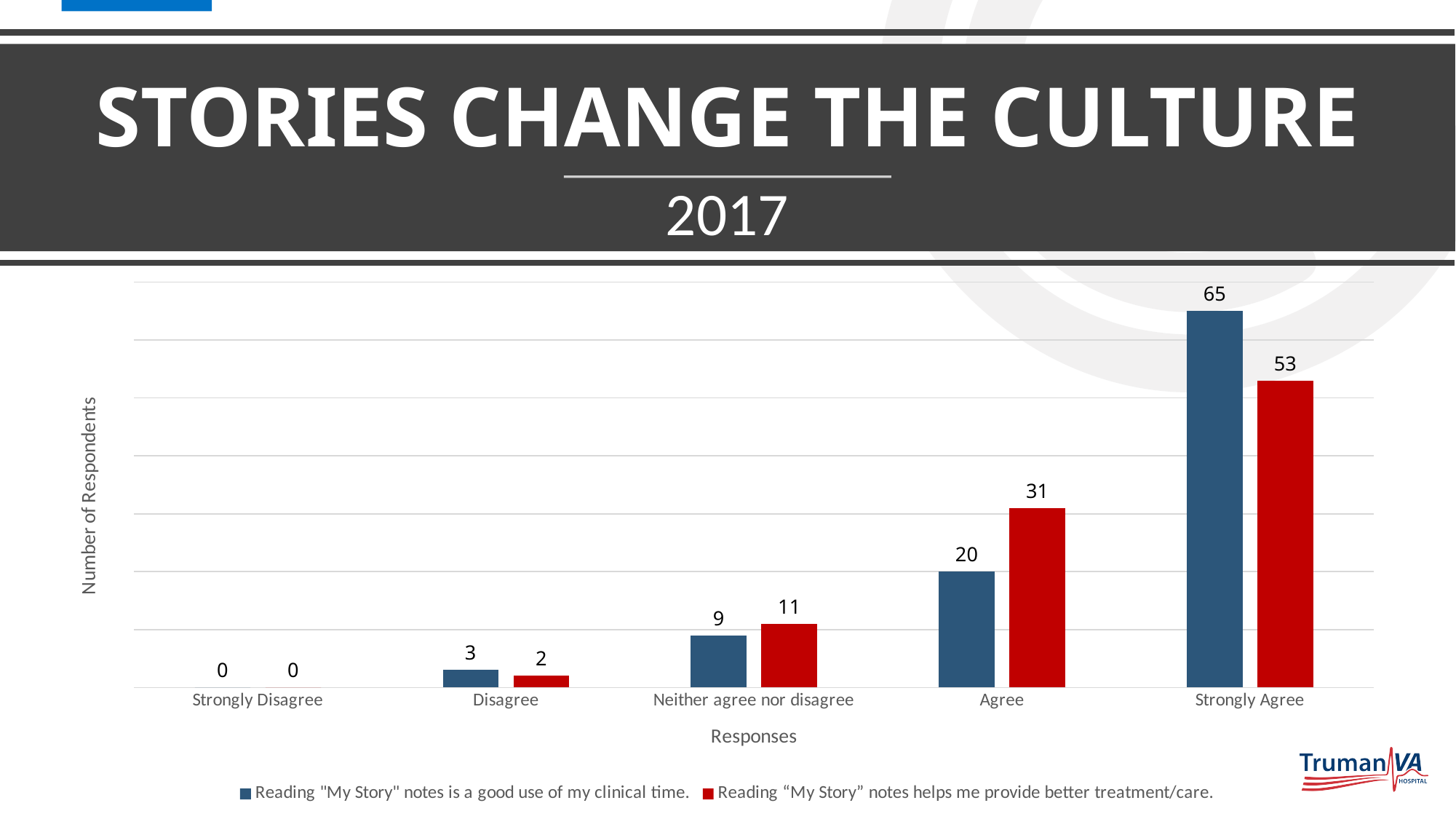
How many response categories are shown on the x axis? 5 What kind of chart is shown on the slide? Bar chart How many respondents chose Agree for "Reading "My Story" notes helps me provide better treatment/care."? 31 What is the difference between the two series' values for Strongly Agree? 12 What is the label of the y axis? Number of Respondents What is the difference between the Agree and Neither agree nor disagree values in the "helps me provide better treatment/care" series? 20 How many respondents chose Strongly Agree for "Reading "My Story" notes is a good use of my clinical time."? 65 Which response category has the highest value for the "helps me provide better treatment/care" series? Strongly Agree How many series does the legend list? 2 For the Agree category, which series has the larger value? Reading "My Story" notes helps me provide better treatment/care. Which response category has the lowest value for the "good use of my clinical time" series? Strongly Disagree What is the value for Neither agree nor disagree in the "good use of my clinical time" series? 9